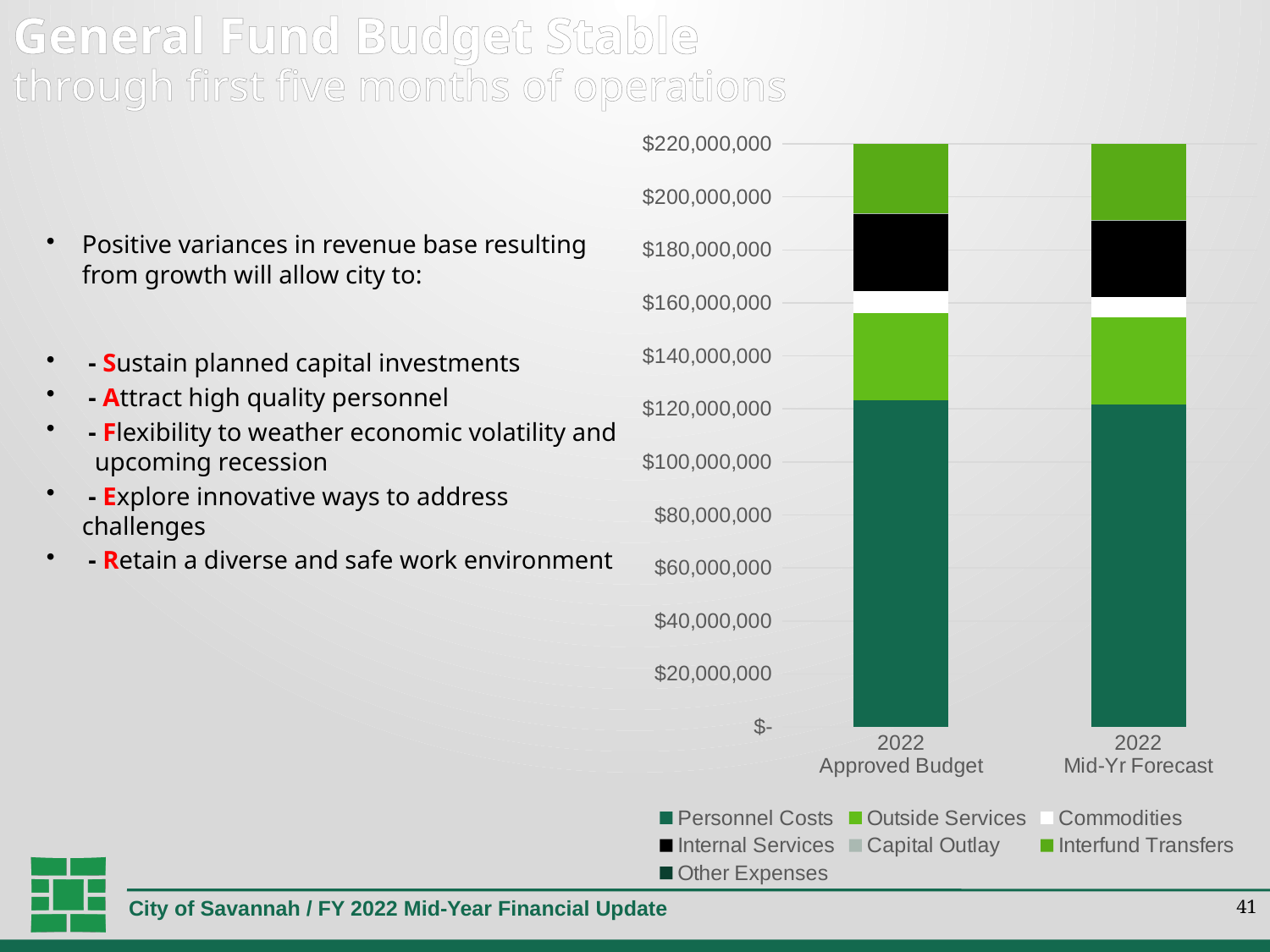
How many bars (categories) are plotted on the chart? 2 Is the Personnel Costs value for the 2022 Approved Budget greater or less than $100,000,000? greater In the 2022 Approved Budget bar, which is larger: Personnel Costs or Outside Services? Personnel Costs Is the Personnel Costs value for the 2022 Mid-Yr Forecast greater or less than $140,000,000? less What kind of chart is shown on the slide? Stacked bar chart Is the total of the 2022 Approved Budget stacked bar greater or less than $200,000,000? greater How many series does the chart legend list? 7 Which series is shown in black in the legend? Internal Services Which series has the largest segment in the 2022 Approved Budget bar? Personnel Costs Which series forms the bottom segment of each stacked bar? Personnel Costs In the 2022 Mid-Yr Forecast bar, which is larger: Internal Services or Commodities? Internal Services